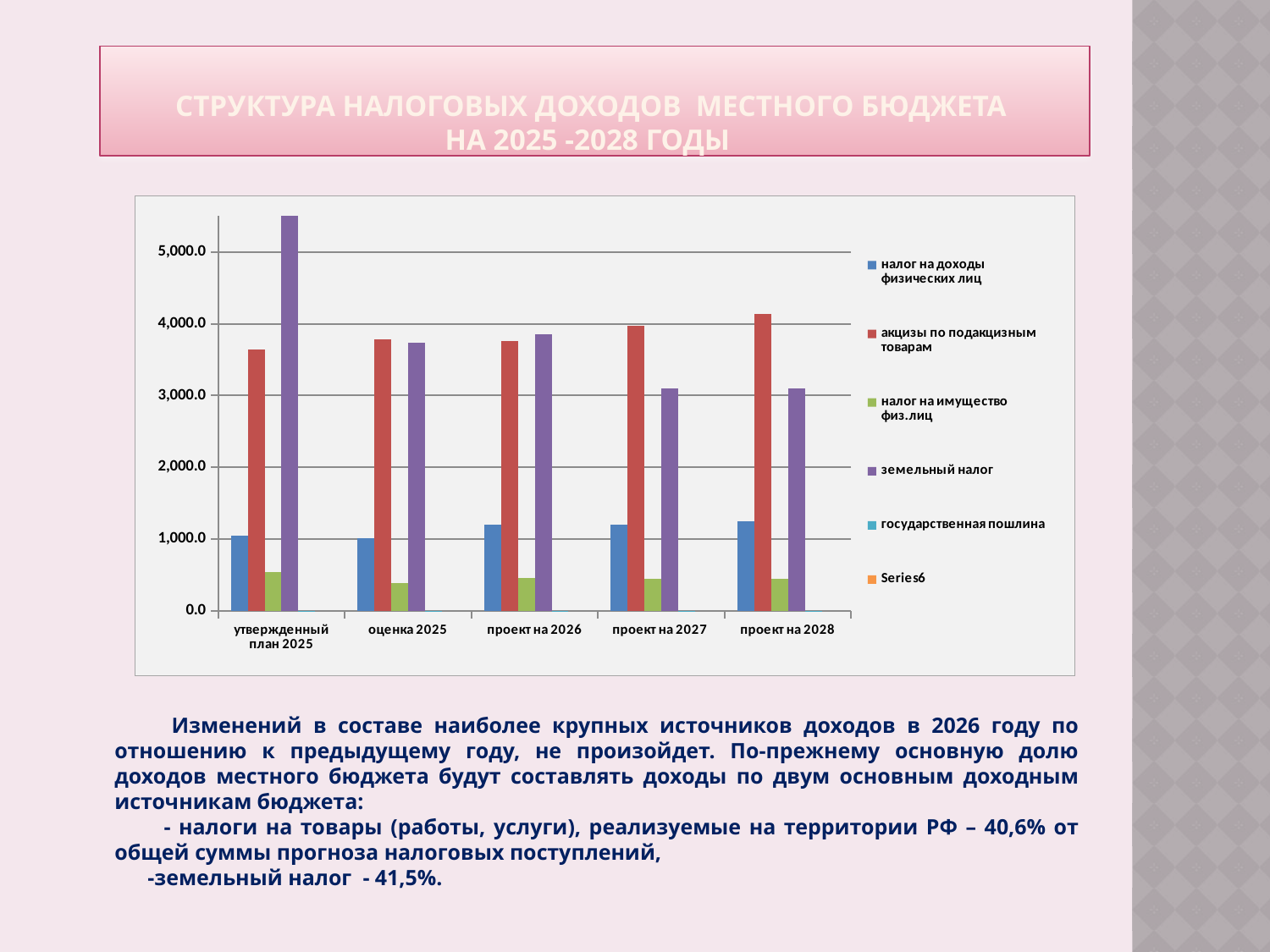
Which series is shown in purple in the chart legend? земельный налог Which series has the highest value in the проект на 2028 category? акцизы по подакцизным товарам Is the value of акцизы по подакцизным товарам for проект на 2028 greater or less than 4,000.0? greater Which category has the highest value of земельный налог? утвержденный план 2025 In the проект на 2027 category, which is larger: акцизы по подакцизным товарам or земельный налог? акцизы по подакцизным товарам Is the value of налог на имущество физ.лиц for утвержденный план 2025 greater or less than 1,000.0? less How many series does the chart legend list? 6 What kind of chart is shown on the slide? bar chart How many categories are shown along the x axis of the chart? 5 Is the value of земельный налог for утвержденный план 2025 greater or less than 5,000.0? greater Which series has the highest value in the утвержденный план 2025 category? земельный налог